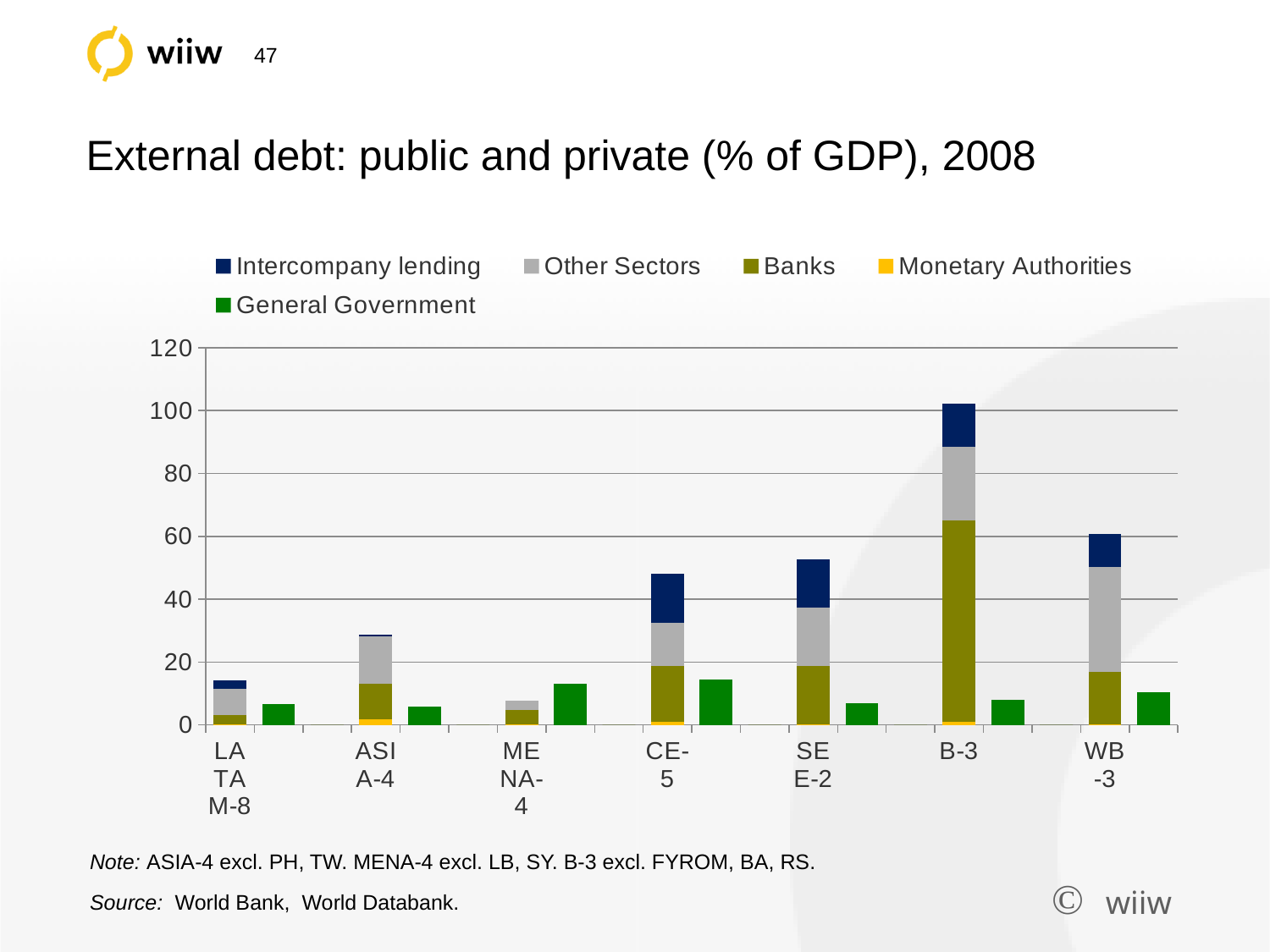
Is the total of the stacked bar for B-3 greater or less than 80? greater What is the title of the chart? External debt: public and private (% of GDP), 2008 Which regional group has the shortest stacked bar (private external debt)? MENA-4 Which is larger: the General Government bar for MENA-4 or the General Government bar for LATAM-8? MENA-4 Is the total of the stacked bar for SEE-2 greater or less than 40? greater How many regional groups are shown on the x axis? 7 Is the General Government value for MENA-4 greater or less than 20? less How many series does the legend list? 5 What kind of chart is shown on the slide? Stacked bar chart Which regional group has the tallest stacked bar (private external debt)? B-3 Which is larger: the stacked bar for B-3 or the stacked bar for SEE-2? B-3